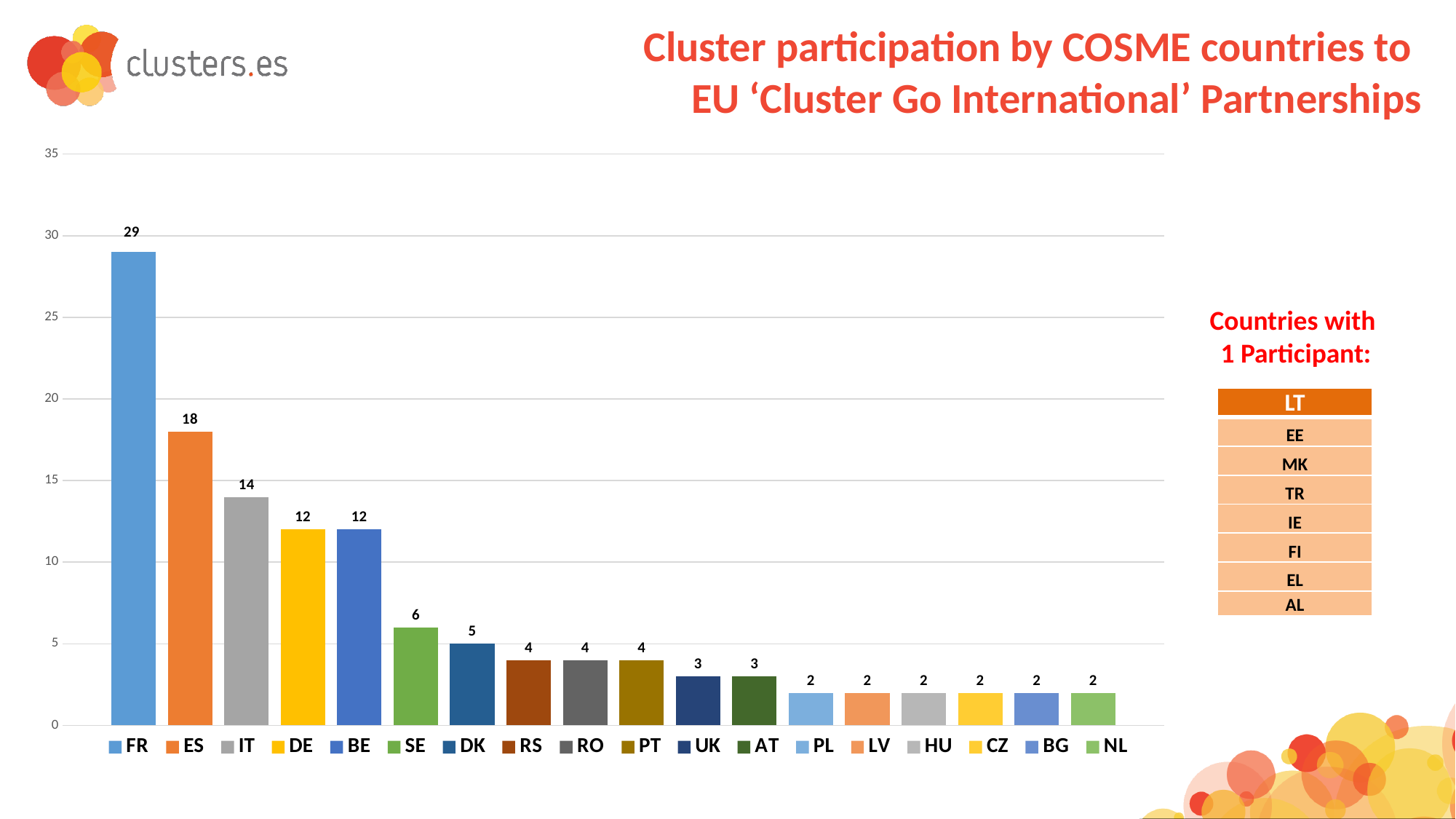
Is the value for FR greater or less than 25? greater What is the difference between the values for IT and DK? 9 What is the difference between the values for FR and ES? 11 What is the value for ES? 18 Which is larger, the value for IT or the value for DE? IT Do the values rise or fall from left to right along the x axis? fall What is the value for FR? 29 What is the value for UK? 3 How many countries are plotted as bars in the chart? 18 What kind of chart is shown on the slide? bar chart What is the value for SE? 6 Which country has the highest value? FR